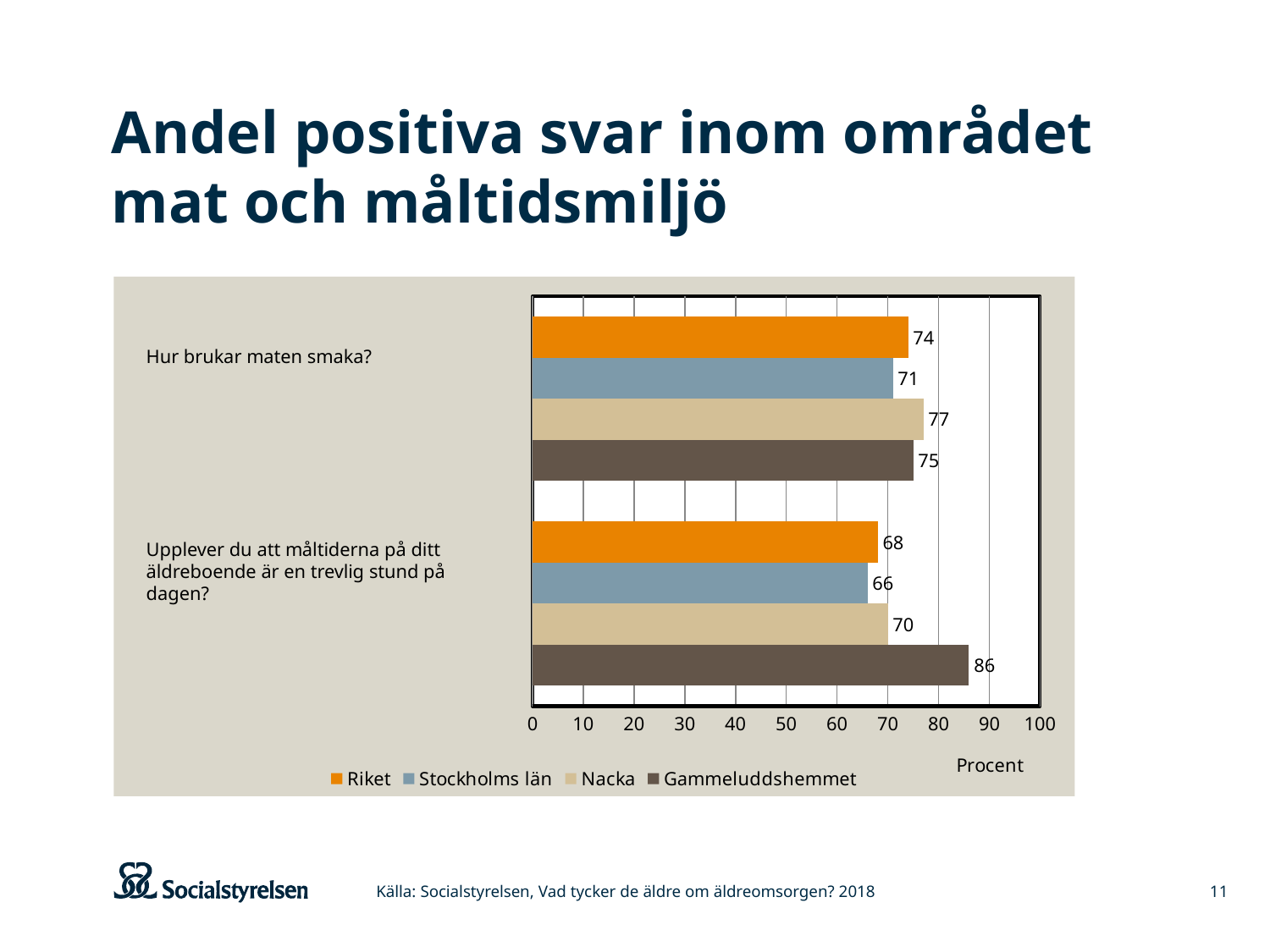
What value is shown for Nacka on the question "Hur brukar maten smaka?"? 77 What is the difference between Gammeluddshemmet and Riket on the question "Upplever du att måltiderna på ditt äldreboende är en trevlig stund på dagen?"? 18 What value is shown for Riket on the question "Upplever du att måltiderna på ditt äldreboende är en trevlig stund på dagen?"? 68 Which is larger on the question "Hur brukar maten smaka?": Nacka or Riket? Nacka Which series has the lowest value on the question "Hur brukar maten smaka?"? Stockholms län What kind of chart is shown on the slide? Bar chart What is the label on the horizontal axis of the chart? Procent What value is shown for Gammeluddshemmet on the question "Upplever du att måltiderna på ditt äldreboende är en trevlig stund på dagen?"? 86 Which series has the highest value on the question "Upplever du att måltiderna på ditt äldreboende är en trevlig stund på dagen?"? Gammeluddshemmet Is the value for Stockholms län on the question "Upplever du att måltiderna på ditt äldreboende är en trevlig stund på dagen?" greater or less than 70? less How many series does the legend list? 4 What value is shown for Stockholms län on the question "Hur brukar maten smaka?"? 71